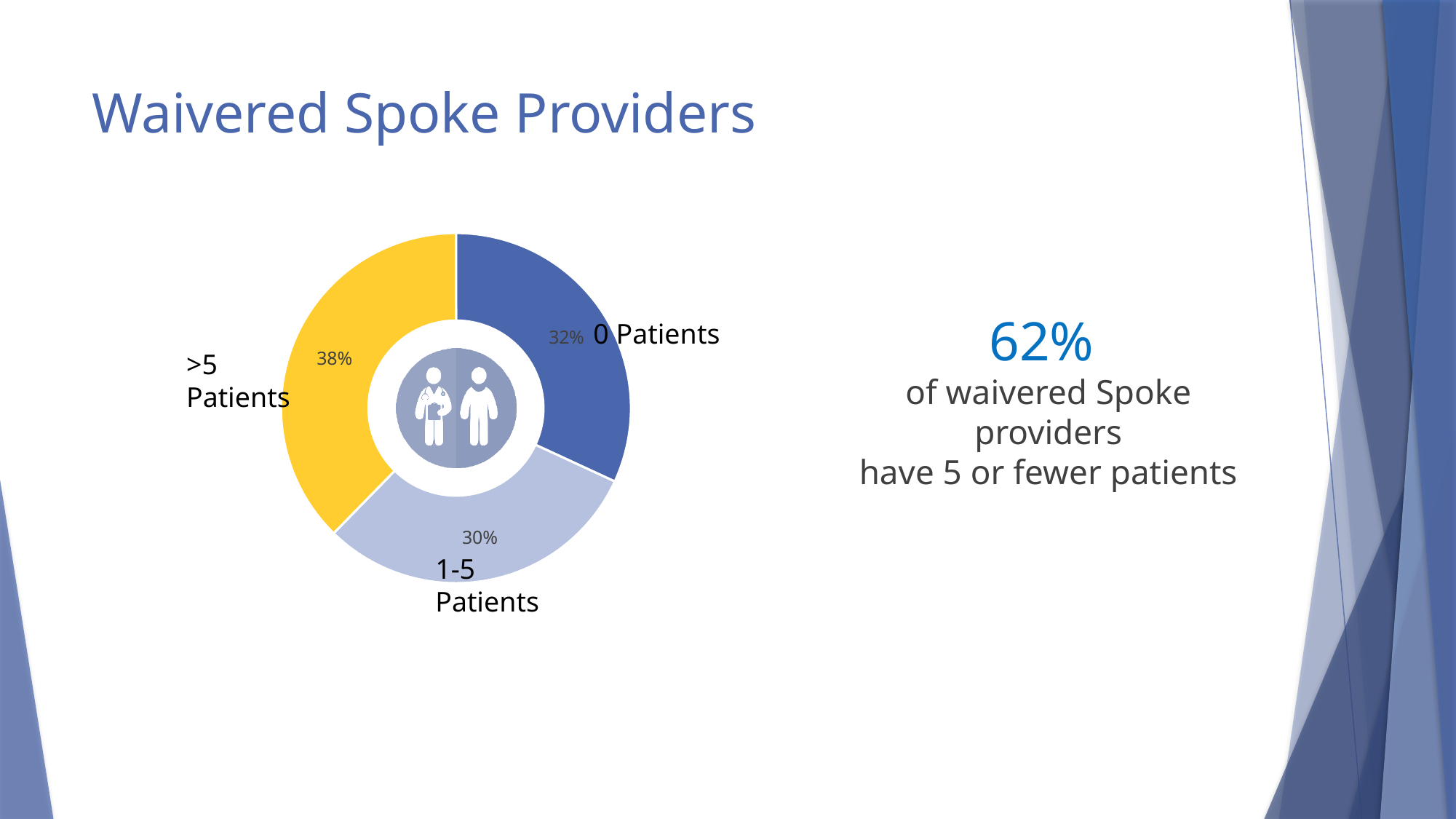
What is the combined share of the 0 Patients and 1-5 Patients slices? 62% Which category has the largest share of the pie? >5 Patients What percentage of waivered Spoke providers have 0 Patients? 32% How many categories does the pie chart show? 3 What is the title of the slide containing the chart? Waivered Spoke Providers Which is larger, the share for 0 Patients or the share for >5 Patients? >5 Patients What is the difference in percentage points between the >5 Patients slice and the 1-5 Patients slice? 8 What colour is the >5 Patients slice? Yellow What percentage of waivered Spoke providers have >5 Patients? 38% What kind of chart is shown on the slide? Pie chart (doughnut) Which category has the smallest share of the pie? 1-5 Patients What percentage of waivered Spoke providers have 1-5 Patients? 30%